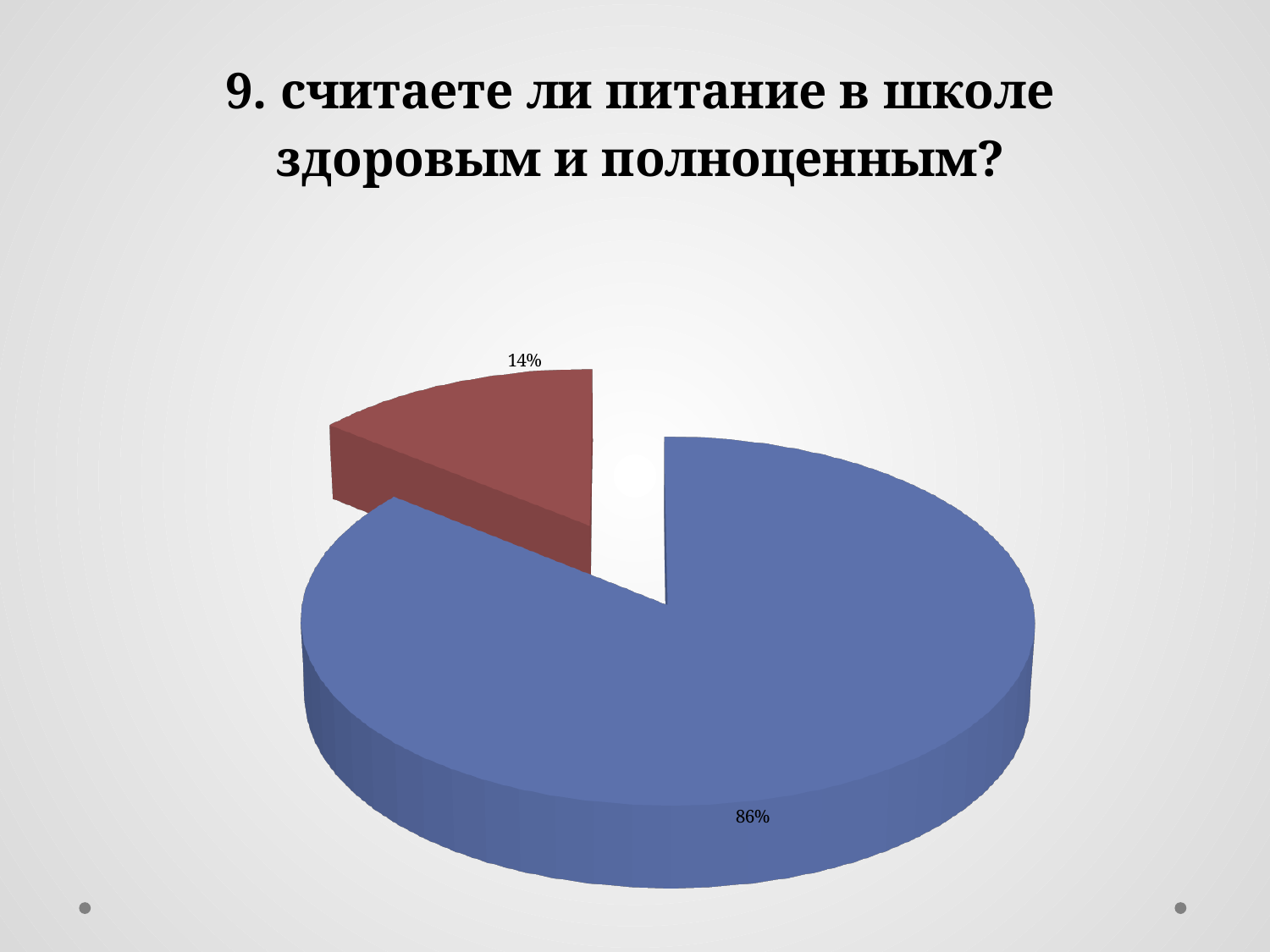
How many slices does the pie chart have? 2 What is the difference in percentage points between the blue slice and the red slice? 72 What is the total of the two percentages shown on the pie chart? 100% Which slice of the pie chart is the largest? the blue slice (86%) Which slice is larger, the blue one or the red one? the blue one Which slice of the pie chart is the smallest? the red slice (14%) What is the title of the slide containing the pie chart? 9. считаете ли питание в школе здоровым и полноценным? Which slice of the pie chart is pulled out (exploded) from the rest? the red slice What percentage is shown on the blue slice of the pie chart? 86% What kind of chart is shown on the slide? pie chart What share of the pie does the red slice represent? 14% What percentage is shown on the red slice of the pie chart? 14%